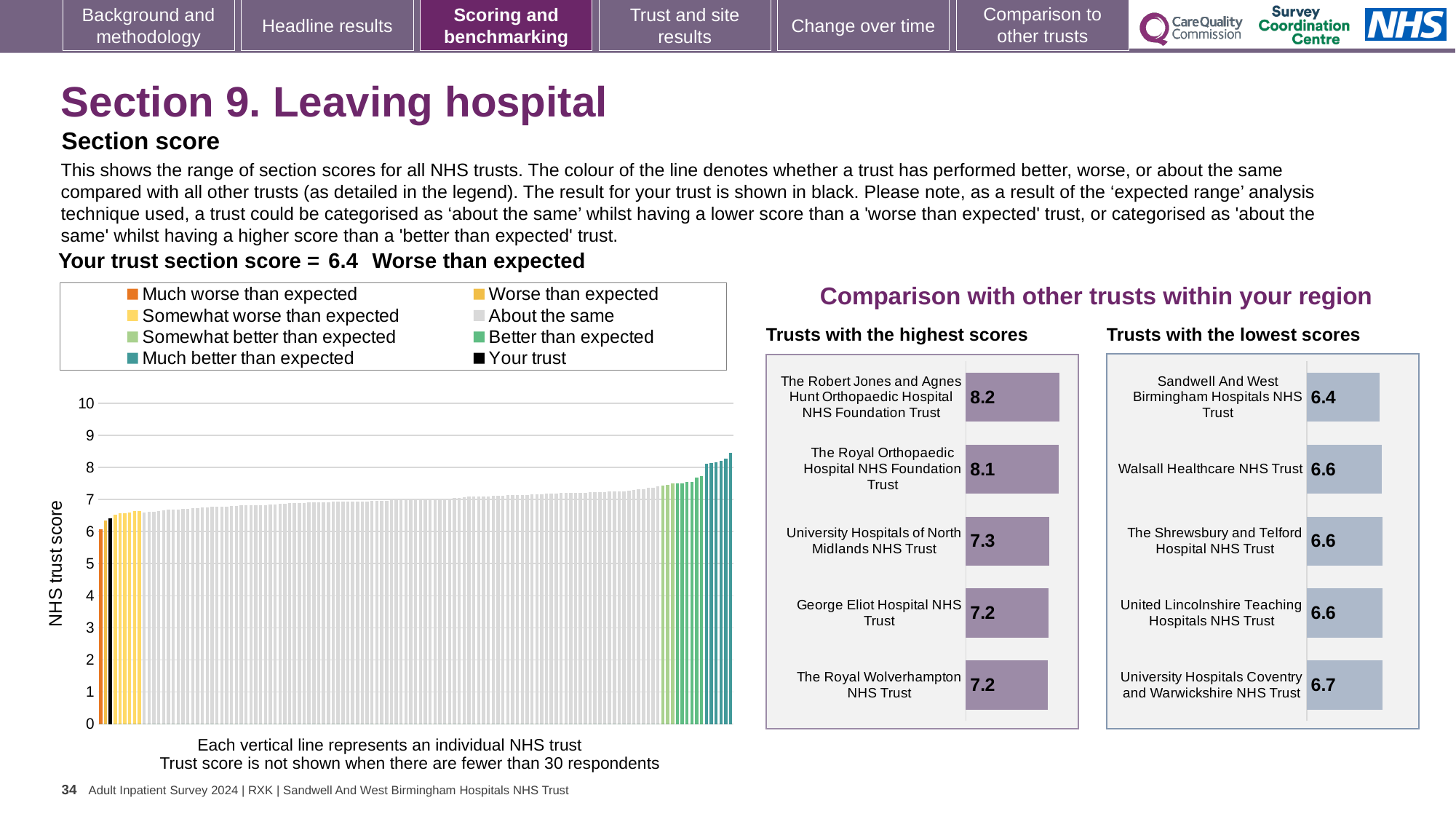
How many entries does the legend of the NHS trust score chart on the left list? 8 In the 'Trusts with the highest scores' chart, what is the score for University Hospitals of North Midlands NHS Trust? 7.3 How many trusts are shown in the 'Trusts with the lowest scores' chart? 5 In the 'Trusts with the lowest scores' chart, which trust has the lowest score? Sandwell And West Birmingham Hospitals NHS Trust In the 'Trusts with the lowest scores' chart, what is the score for Walsall Healthcare NHS Trust? 6.6 In the 'Trusts with the highest scores' chart, what is the difference between the scores of The Robert Jones and Agnes Hunt Orthopaedic Hospital NHS Foundation Trust and The Royal Wolverhampton NHS Trust? 1.0 What type of chart is the NHS trust score chart on the left of the slide? Bar chart In the 'Trusts with the lowest scores' chart, what is the difference between the scores of University Hospitals Coventry and Warwickshire NHS Trust and Sandwell And West Birmingham Hospitals NHS Trust? 0.3 In the 'Trusts with the highest scores' chart, which has a higher score: The Royal Orthopaedic Hospital NHS Foundation Trust or George Eliot Hospital NHS Trust? The Royal Orthopaedic Hospital NHS Foundation Trust In the 'Trusts with the highest scores' chart, which trust has the highest score? The Robert Jones and Agnes Hunt Orthopaedic Hospital NHS Foundation Trust In the 'Trusts with the lowest scores' chart, what is the score for University Hospitals Coventry and Warwickshire NHS Trust? 6.7 In the 'Trusts with the highest scores' chart, what is the score for The Robert Jones and Agnes Hunt Orthopaedic Hospital NHS Foundation Trust? 8.2